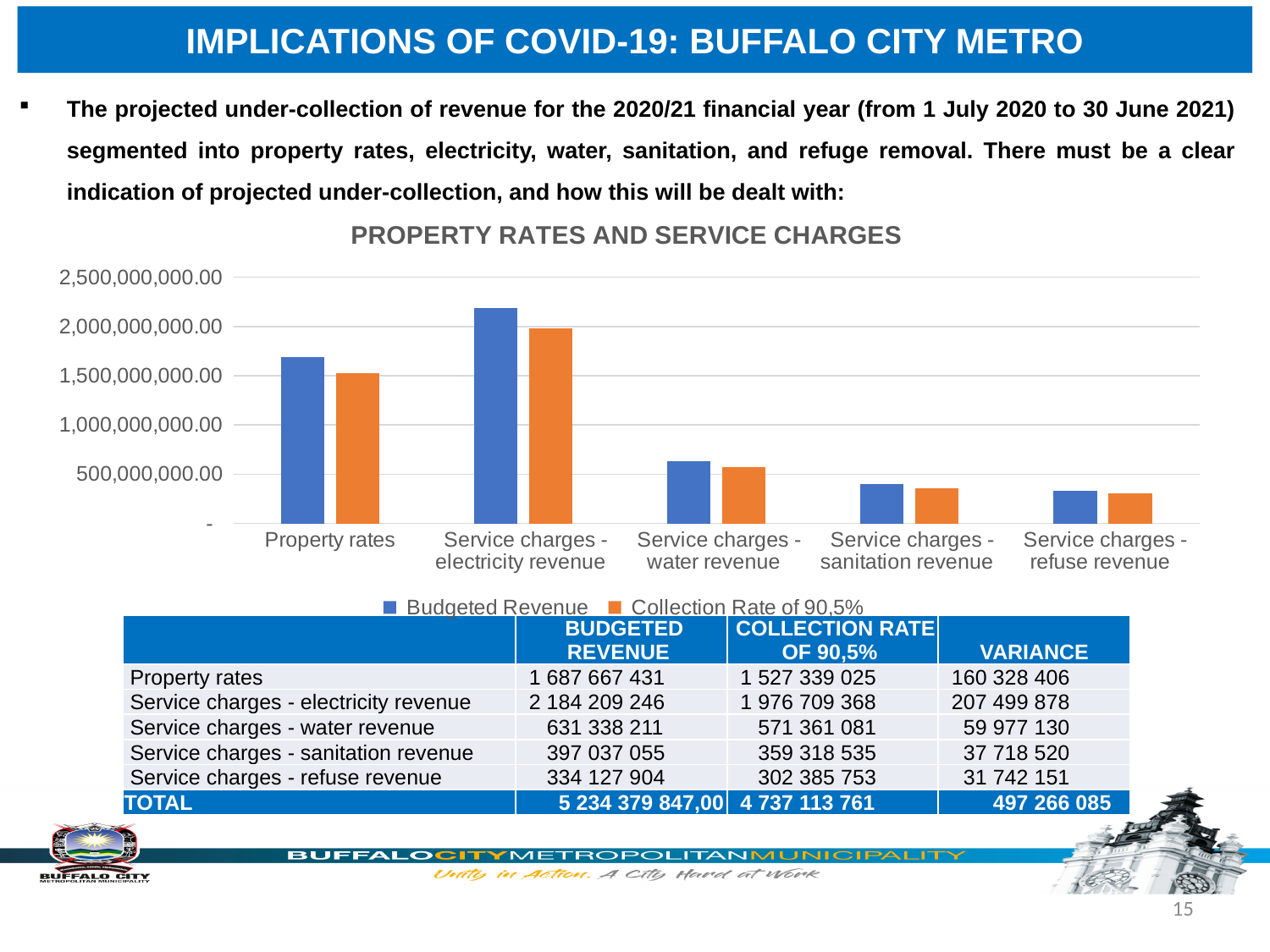
What type of chart is shown under the title 'PROPERTY RATES AND SERVICE CHARGES'? Bar chart Which is larger: the Budgeted Revenue for Property rates or the Budgeted Revenue for Service charges - water revenue? Property rates Is the Budgeted Revenue bar for Service charges - sanitation revenue greater or less than 500,000,000.00? less How many categories are shown on the x axis of the chart? 5 Which category has the lowest Collection Rate of 90,5% bar? Service charges - refuse revenue How many series does the chart legend list? 2 Is the Budgeted Revenue bar for Service charges - electricity revenue greater or less than 2,000,000,000.00? greater According to the table below the chart, what is the Collection Rate of 90,5% value for Service charges - water revenue? 571 361 081 Which category has the highest Budgeted Revenue bar? Service charges - electricity revenue According to the table below the chart, what is the Budgeted Revenue for Service charges - electricity revenue? 2 184 209 246 Moving from Service charges - electricity revenue to Service charges - refuse revenue along the x axis, do the Budgeted Revenue bars rise or fall? Fall